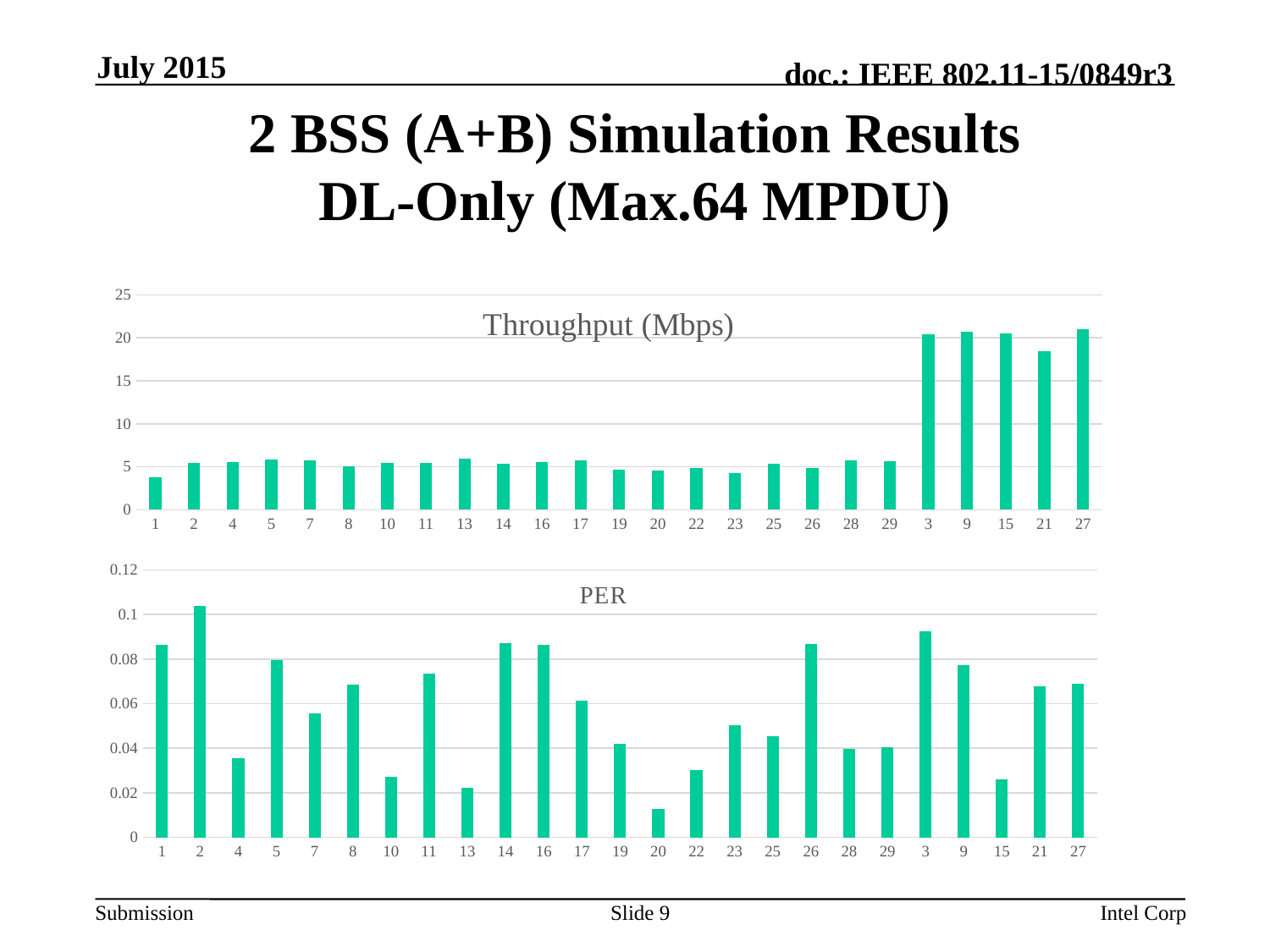
In the PER chart, which category has the highest PER? 2 In the Throughput (Mbps) chart, is the value for category 21 greater or less than 20? less In the Throughput (Mbps) chart, which has the higher throughput, category 9 or category 21? 9 In the PER chart, which category has the lowest PER? 20 In the Throughput (Mbps) chart, is the value for category 27 greater or less than 15? greater In the PER chart, is the value for category 3 greater or less than 0.08? greater In the Throughput (Mbps) chart, which category has the lowest throughput? 1 How many categories are shown on the x axis of the PER chart? 25 In the PER chart, which has the higher PER, category 2 or category 4? 2 What type of chart is the Throughput (Mbps) chart? bar chart